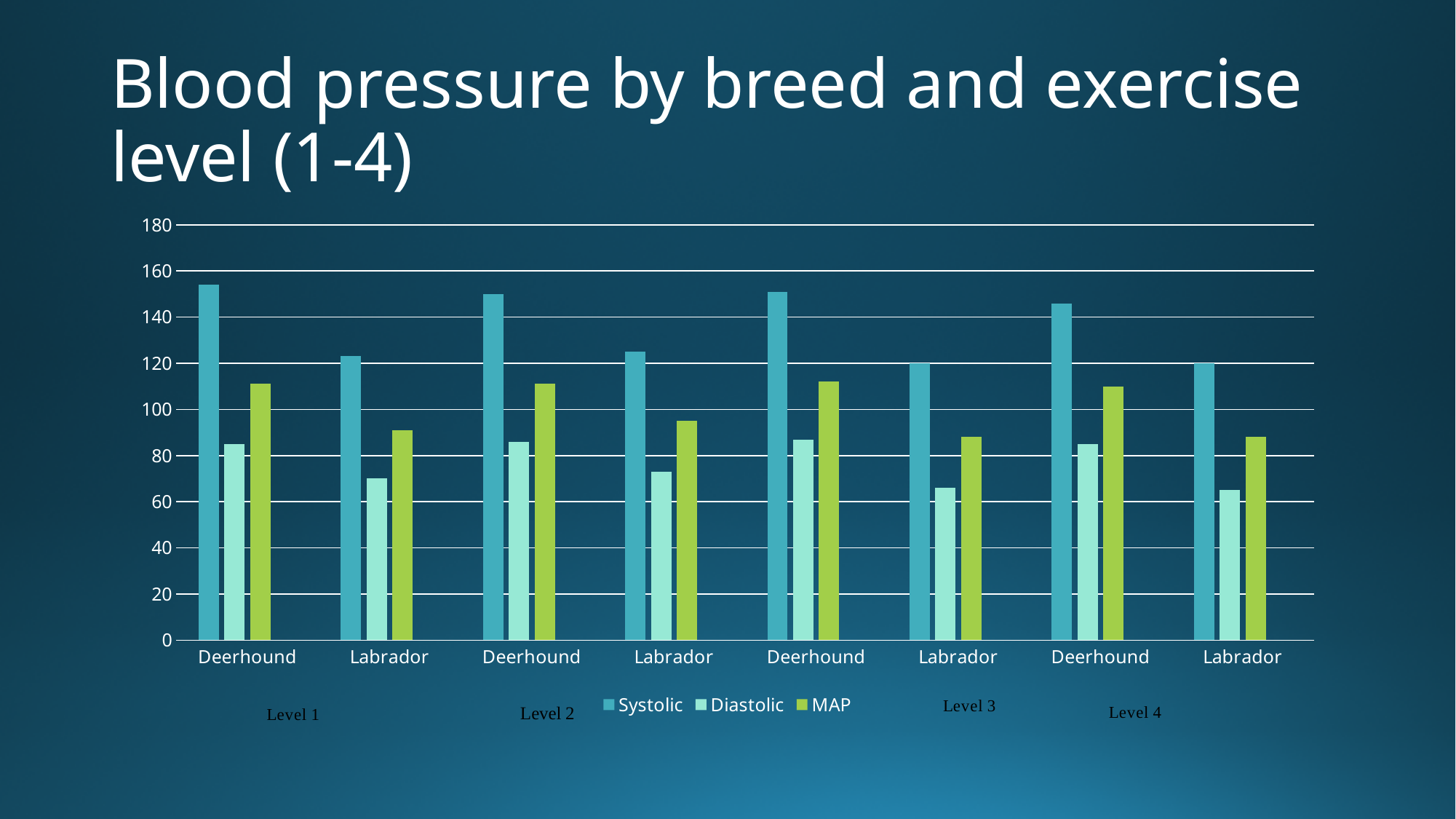
At Level 4, which breed has the higher Diastolic value, Deerhound or Labrador? Deerhound Is the Systolic value for Deerhound at Level 1 greater or less than 140? greater At Level 1, which breed has the higher Systolic value, Deerhound or Labrador? Deerhound How many category groups are shown along the x axis? 8 What kind of chart is shown on the slide? bar chart How many series does the legend list? 3 Is the Diastolic value for Labrador at Level 1 greater or less than 80? less Which is larger, the MAP value for Labrador at Level 2 or the MAP value for Labrador at Level 3? Labrador at Level 2 Is the Diastolic value for Labrador at Level 3 greater or less than 80? less Which series is shown in green in the legend? MAP